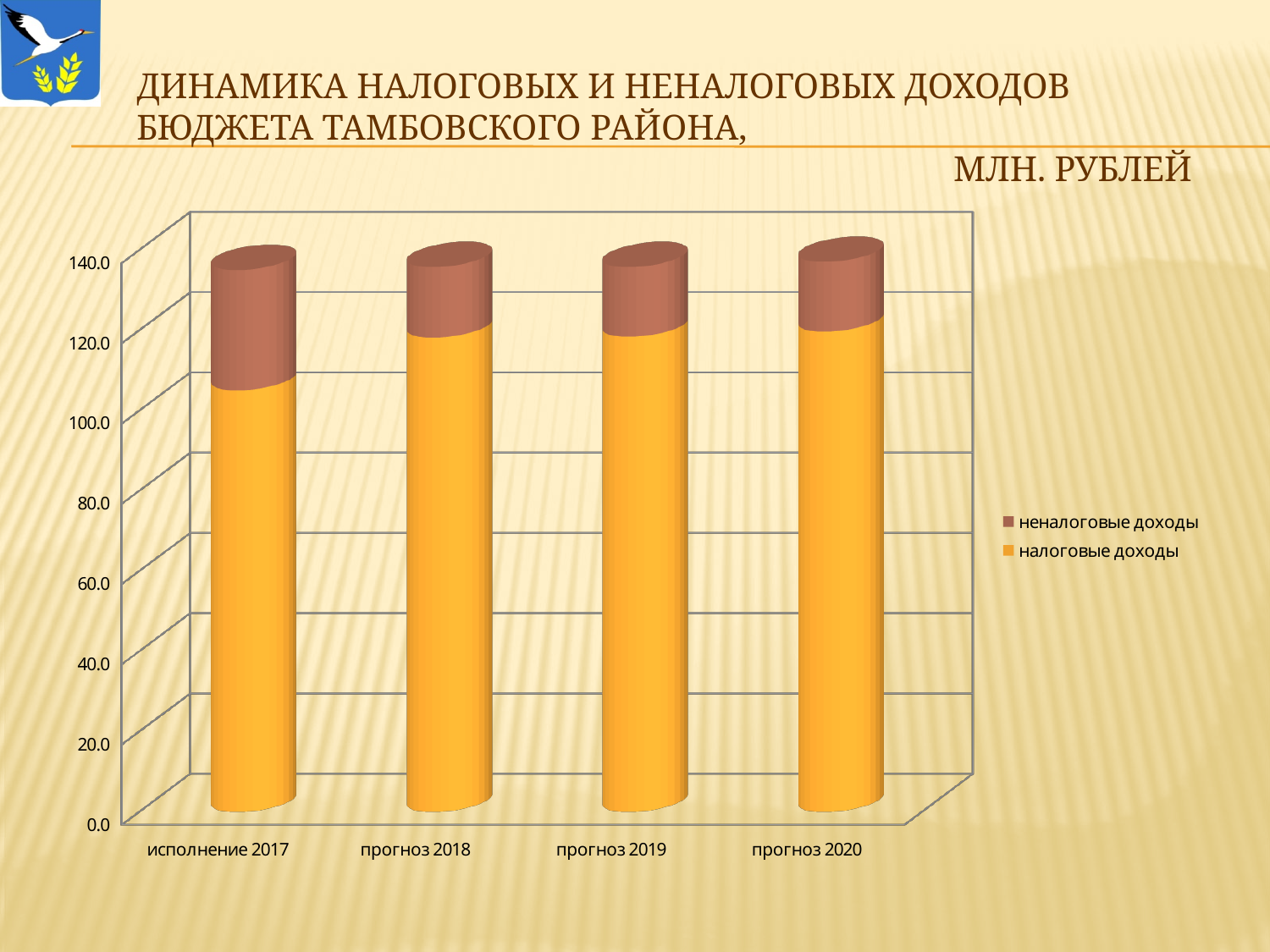
Which series are listed in the chart legend? неналоговые доходы, налоговые доходы Is the value for налоговые доходы in исполнение 2017 greater or less than 100.0? greater Do the values for налоговые доходы rise or fall from исполнение 2017 to прогноз 2020? rise What kind of chart is shown on the slide? stacked bar chart Which is larger: налоговые доходы in исполнение 2017 or in прогноз 2020? прогноз 2020 Which category has the highest value for неналоговые доходы? исполнение 2017 Which is larger: неналоговые доходы in исполнение 2017 or in прогноз 2019? исполнение 2017 Which category has the lowest value for налоговые доходы? исполнение 2017 How many series does the chart legend list? 2 How many categories are shown on the x axis of the chart? 4 Is the value for неналоговые доходы in исполнение 2017 greater or less than 20.0? greater Is the value for налоговые доходы in исполнение 2017 greater or less than 120.0? less